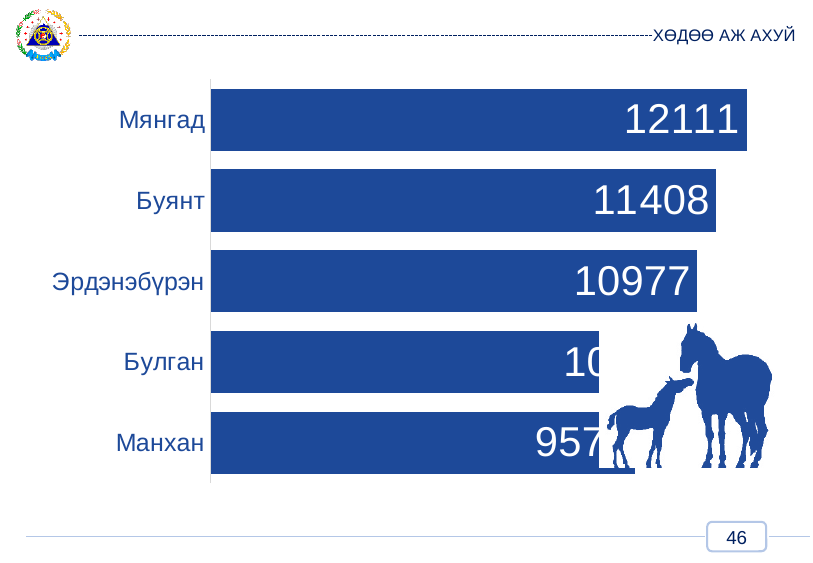
Which category has the highest value? Мянгад What is the value for Эрдэнэбүрэн? 10977 How many categories are shown in the chart? 5 What is the difference between the values for Мянгад and Эрдэнэбүрэн? 1134 What kind of chart is shown on the slide? Bar chart What is the value for Мянгад? 12111 What is the difference between the values for Буянт and Эрдэнэбүрэн? 431 Which category has the lowest value? Манхан Do the bar values increase or decrease going from the top category to the bottom category? Decrease Which is larger, the value for Буянт or the value for Булган? Буянт What is the value for Буянт? 11408 What is the difference between the values for Мянгад and Буянт? 703